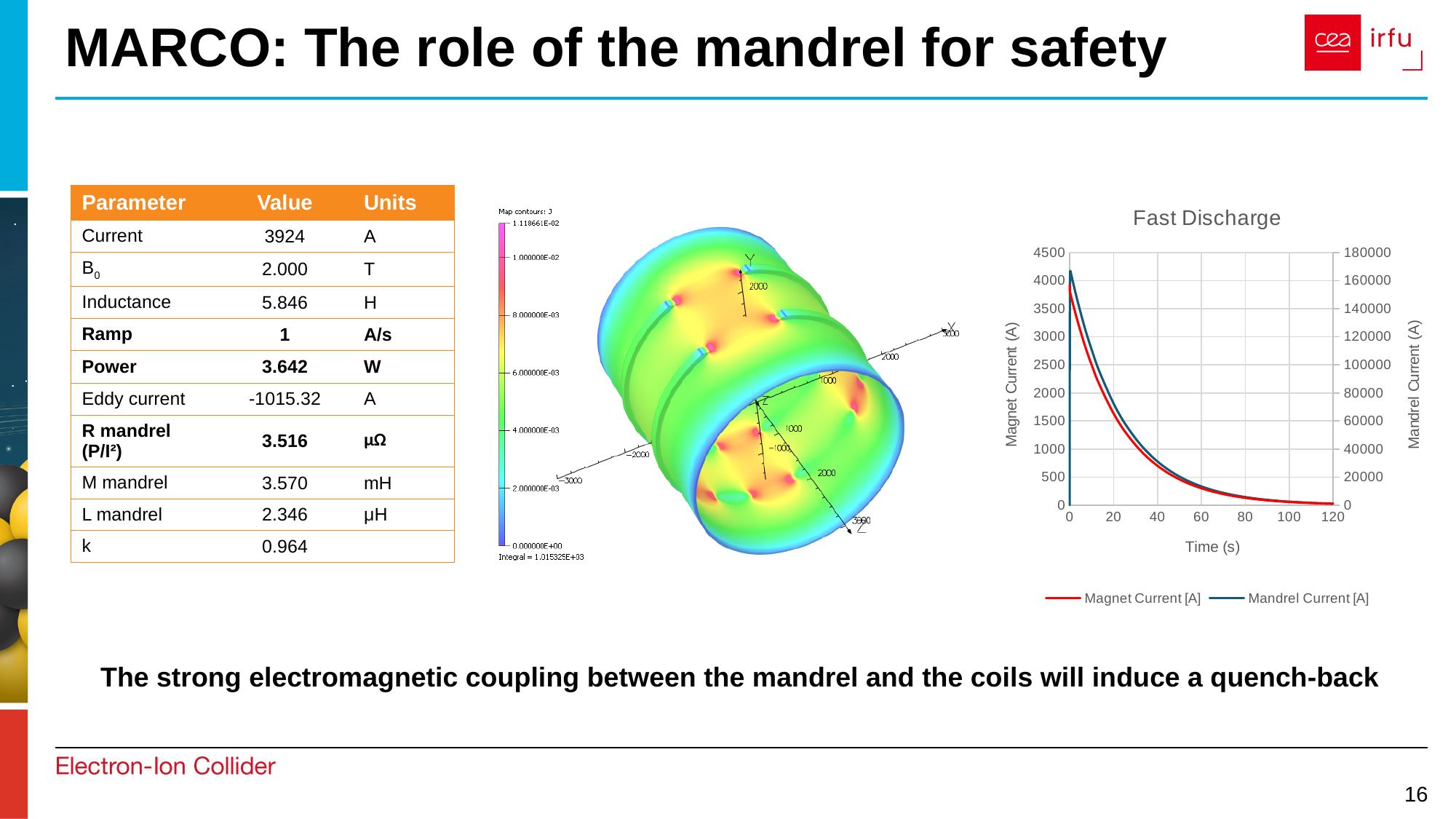
In the 'Fast Discharge' chart, is the Magnet Current at 120 s greater or less than 500 A? less In the 'Fast Discharge' chart, is the peak Mandrel Current greater or less than 140000 A? greater In the 'Fast Discharge' chart, what is the label of the x axis? Time (s) What is the title of the chart on the right of the slide? Fast Discharge In the 'Fast Discharge' chart, what is the maximum value shown on the x axis? 120 In the 'Fast Discharge' chart, does the Mandrel Current rise or fall as time increases? fall In the 'Fast Discharge' chart, is the Magnet Current at 60 s greater or less than 1000 A? less In the 'Fast Discharge' chart, does the Magnet Current rise or fall as time increases? fall How many series does the legend of the 'Fast Discharge' chart list? 2 What kind of chart is the 'Fast Discharge' chart? line chart